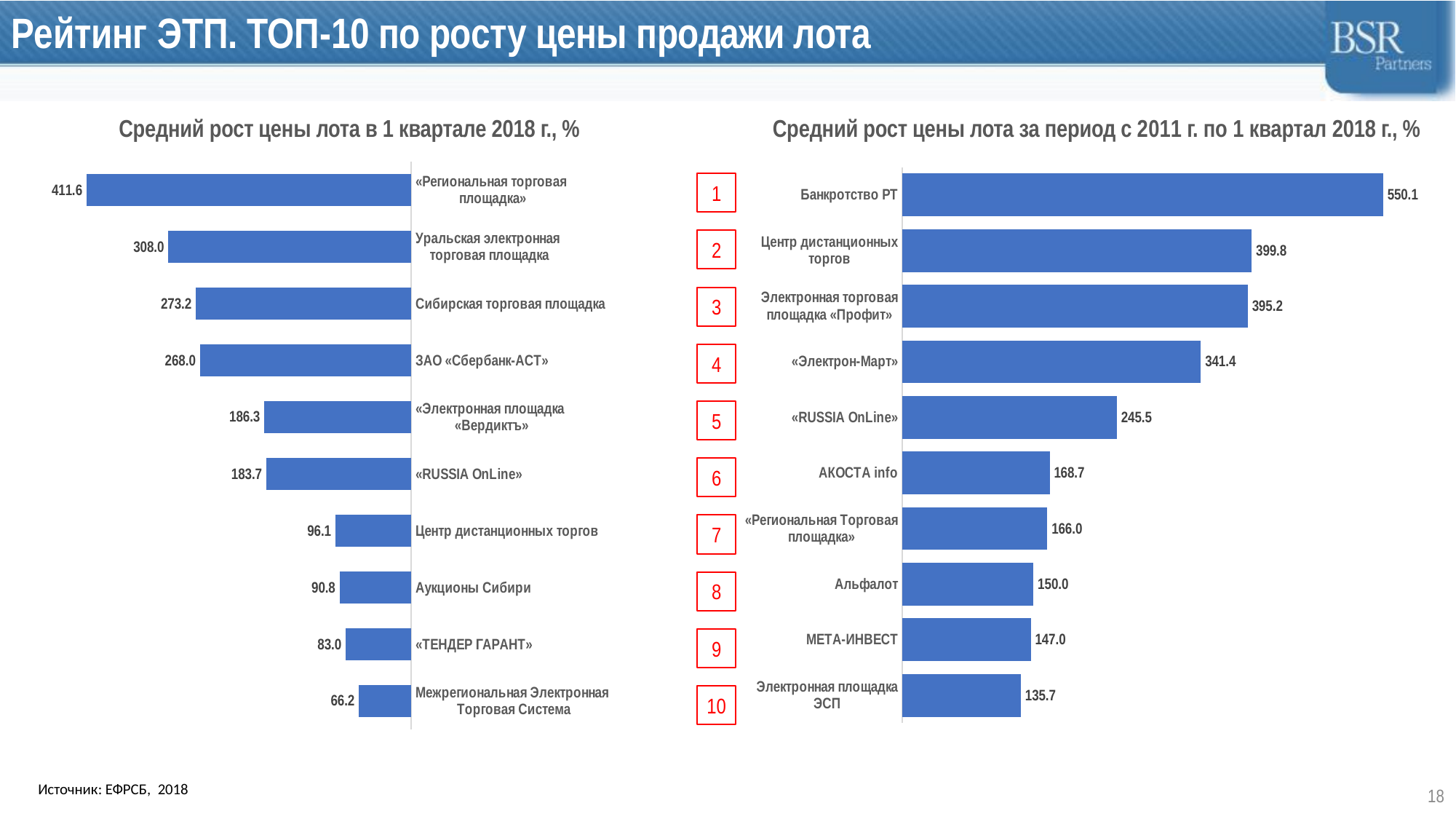
In the right chart, what is the value for Электронная площадка ЭСП? 135.7 In the right chart, what is the difference between the values for Центр дистанционных торгов and Электронная торговая площадка «Профит»? 4.6 What kind of chart is the right chart? Bar chart In the right chart, which is larger: the value for «Электрон-Март» or the value for «RUSSIA OnLine»? «Электрон-Март» In the left chart, what is the value for ЗАО «Сбербанк-АСТ»? 268.0 How many categories are shown in the left chart? 10 In the left chart 'Средний рост цены лота в 1 квартале 2018 г., %', what is the value for «Региональная торговая площадка»? 411.6 In the right chart, which category has the highest value? Банкротство РТ In the left chart, which category has the lowest value? Межрегиональная Электронная Торговая Система In the left chart, what is the difference between the values for «Региональная торговая площадка» and Уральская электронная торговая площадка? 103.6 In the left chart, which is larger: the value for Центр дистанционных торгов or the value for Аукционы Сибири? Центр дистанционных торгов In the right chart 'Средний рост цены лота за период с 2011 г. по 1 квартал 2018 г., %', what is the value for Банкротство РТ? 550.1